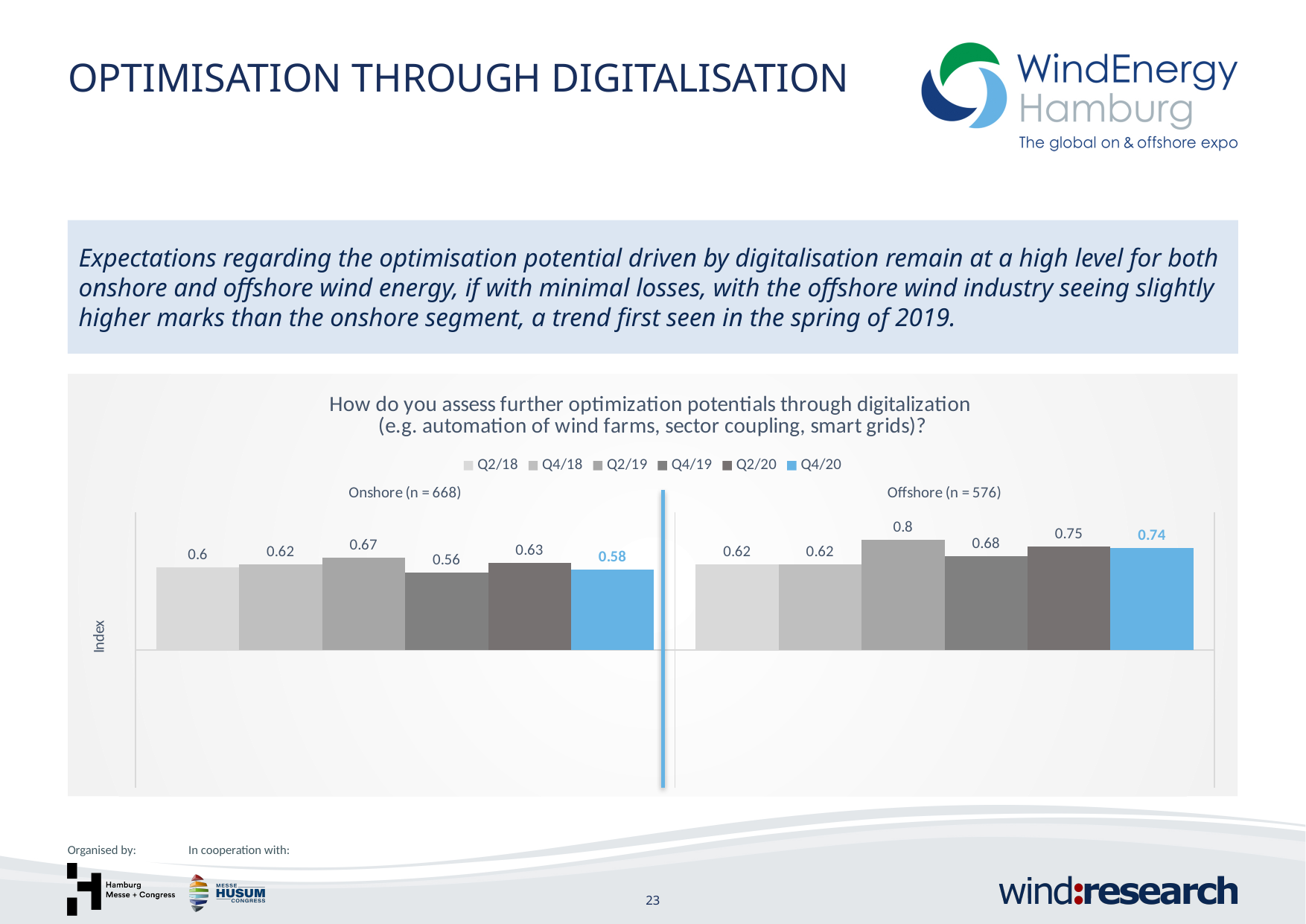
Which survey wave has the lowest value for Onshore? Q4/19 What is the Q4/20 value for Offshore? 0.74 What is the sample size (n) shown for the Onshore group? 668 What is the Q2/19 value for Onshore? 0.67 What is the Q4/19 value for Onshore? 0.56 Which survey wave has the highest value for Offshore? Q2/19 What is the difference between the Offshore and Onshore values for Q4/20? 0.16 How many bars are plotted for the Offshore group? 6 Which is larger, the Q2/20 value for Onshore or the Q2/20 value for Offshore? Offshore What kind of chart is shown on the slide? Bar chart How many series does the legend list? 6 Which legend entry is shown in blue? Q4/20